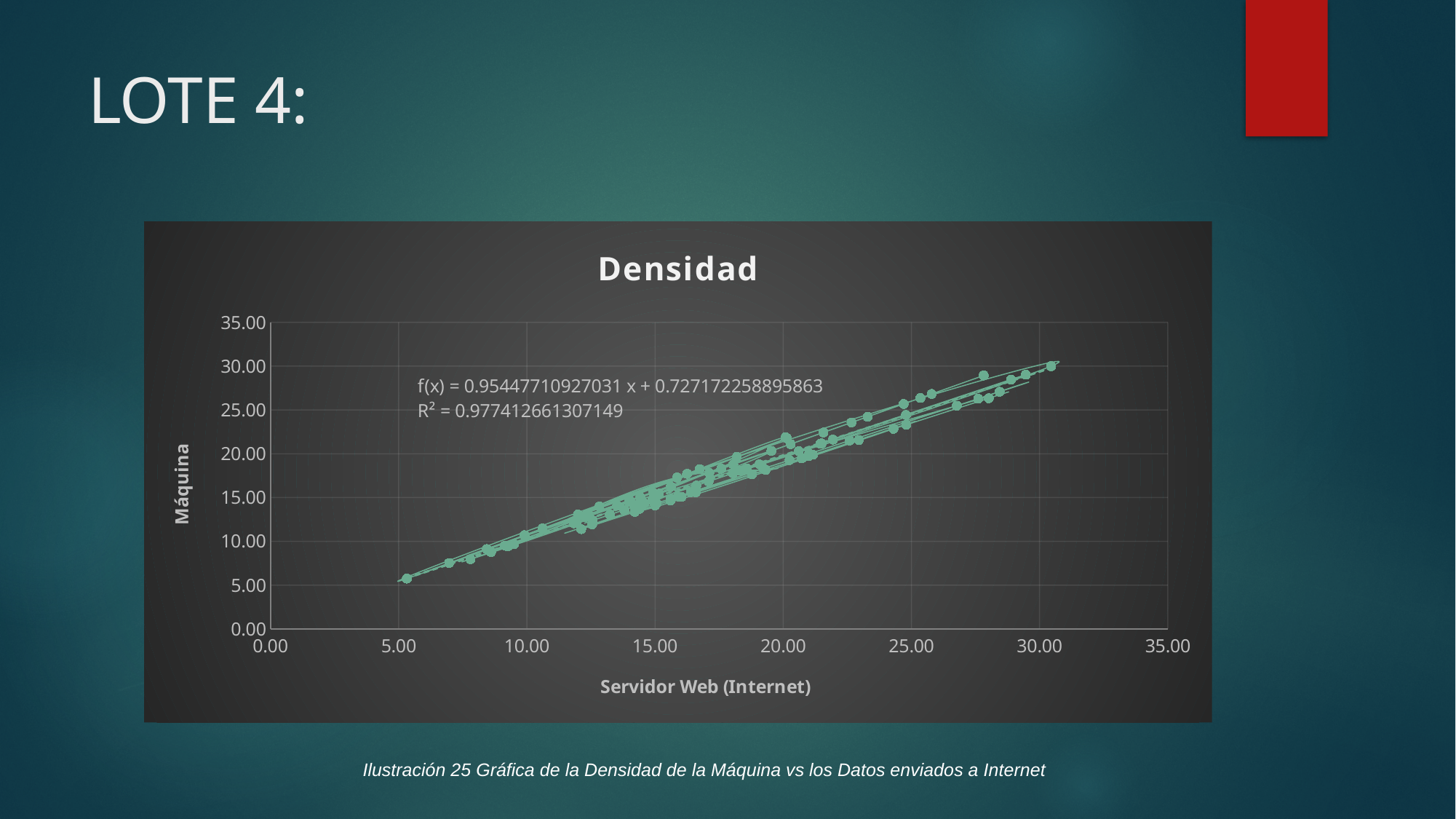
Do the plotted values rise or fall as the x-axis value increases? rise What is the R² value shown on the chart? 0.977412661307149 What is the slope of the trendline equation shown on the chart? 0.95447710927031 What is the intercept of the trendline equation shown on the chart? 0.727172258895863 Is the Máquina value of the highest plotted point greater or less than 25.00? greater Is the Servidor Web (Internet) value of the rightmost plotted point greater or less than 30.00? greater What is the title of the chart? Densidad Is the R² value shown on the chart greater or less than 0.95? greater What kind of chart is shown on the slide? scatter chart What is the maximum value shown on the y axis? 35.00 What is the label of the x axis? Servidor Web (Internet)